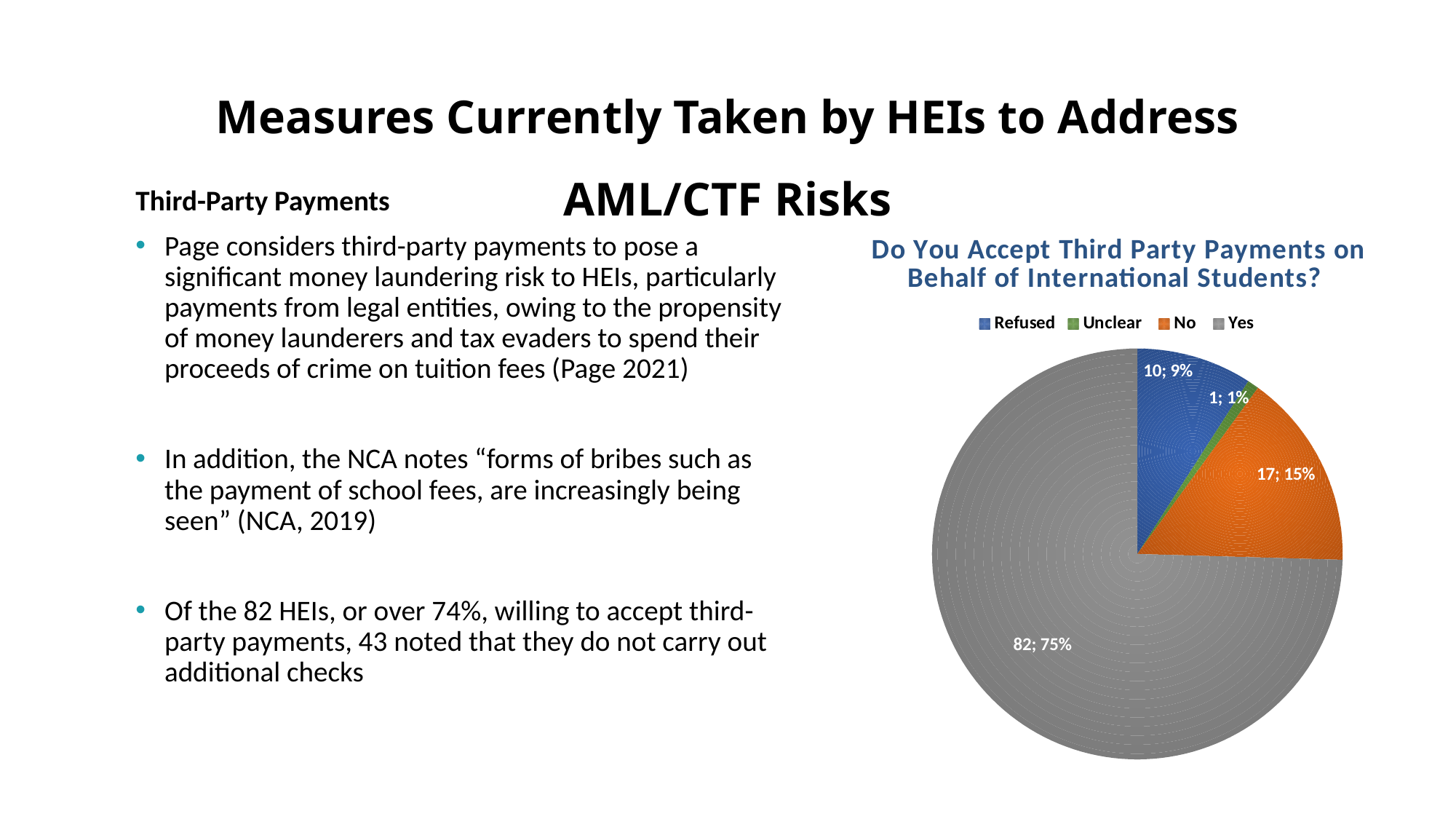
What share of the pie is the No slice? 15% What share of the pie is the Yes slice? 75% What is the title of the chart? Do You Accept Third Party Payments on Behalf of International Students? How many HEIs answered No? 17 How many categories does the legend of the pie chart list? 4 What is the difference between the number of Yes responses and No responses? 65 Which category has the largest slice of the pie? Yes What kind of chart is shown on the slide? pie chart Which category has the smallest slice of the pie? Unclear Which is larger, the No slice or the Refused slice? No How many HEIs Refused? 10 How many HEIs answered Yes? 82